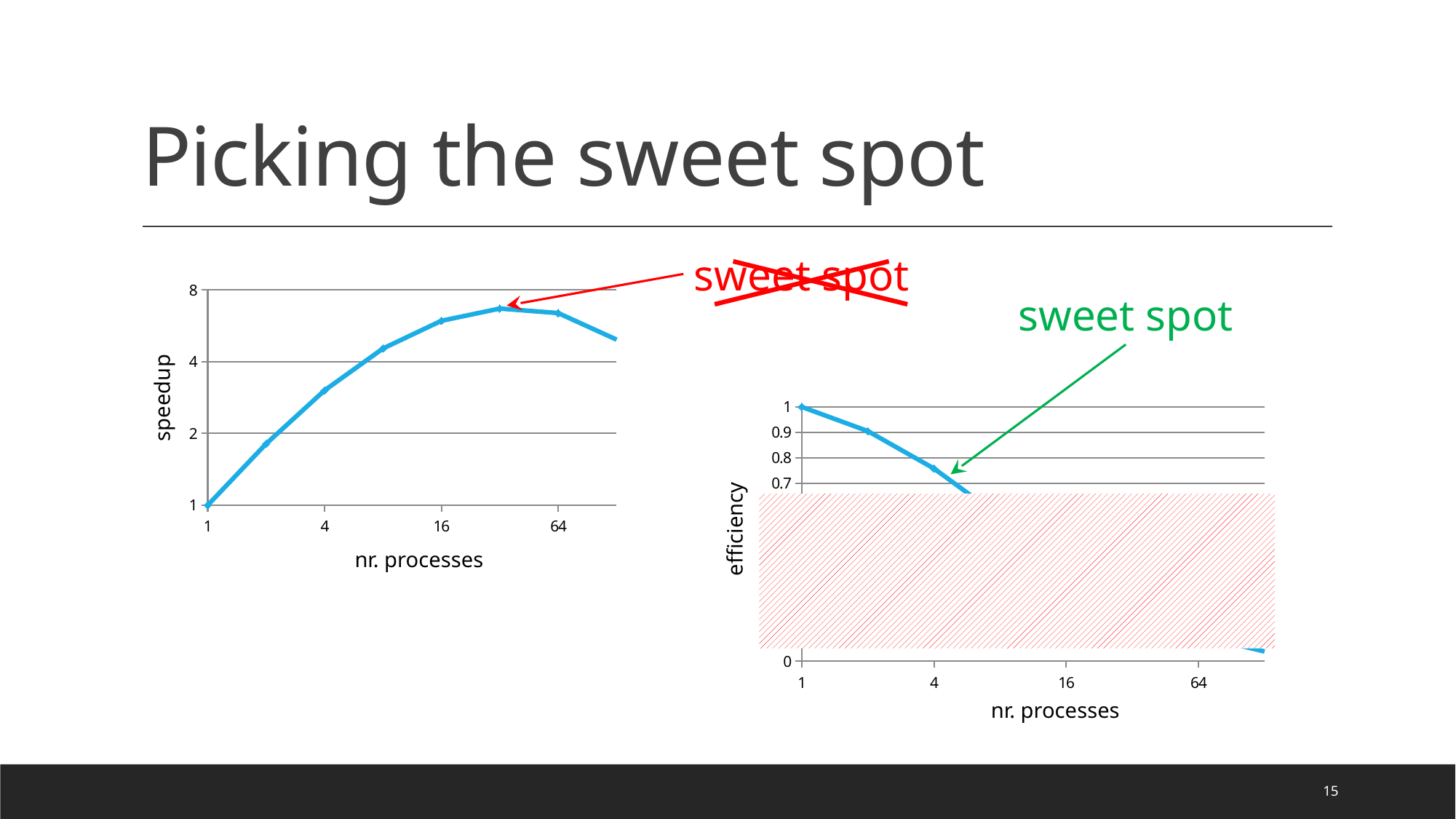
In the left speedup chart, is the speedup at 4 processes greater or less than 2? greater What kind of chart is the left chart with the y axis labelled speedup? line chart In the left speedup chart, which has the larger speedup: 4 processes or 16 processes? 16 processes In the left speedup chart, what is the speedup at 1 process? 1 In the right efficiency chart, is the efficiency at 4 processes greater or less than 0.8? less How many charts are shown on the slide? 2 What is the x-axis label of the left speedup chart? nr. processes In the left speedup chart, is the speedup at 64 processes greater or less than 8? less What is the y-axis label of the right chart? efficiency In the right efficiency chart, what is the efficiency at 1 process? 1 In the right efficiency chart, does efficiency rise or fall as the number of processes increases? fall